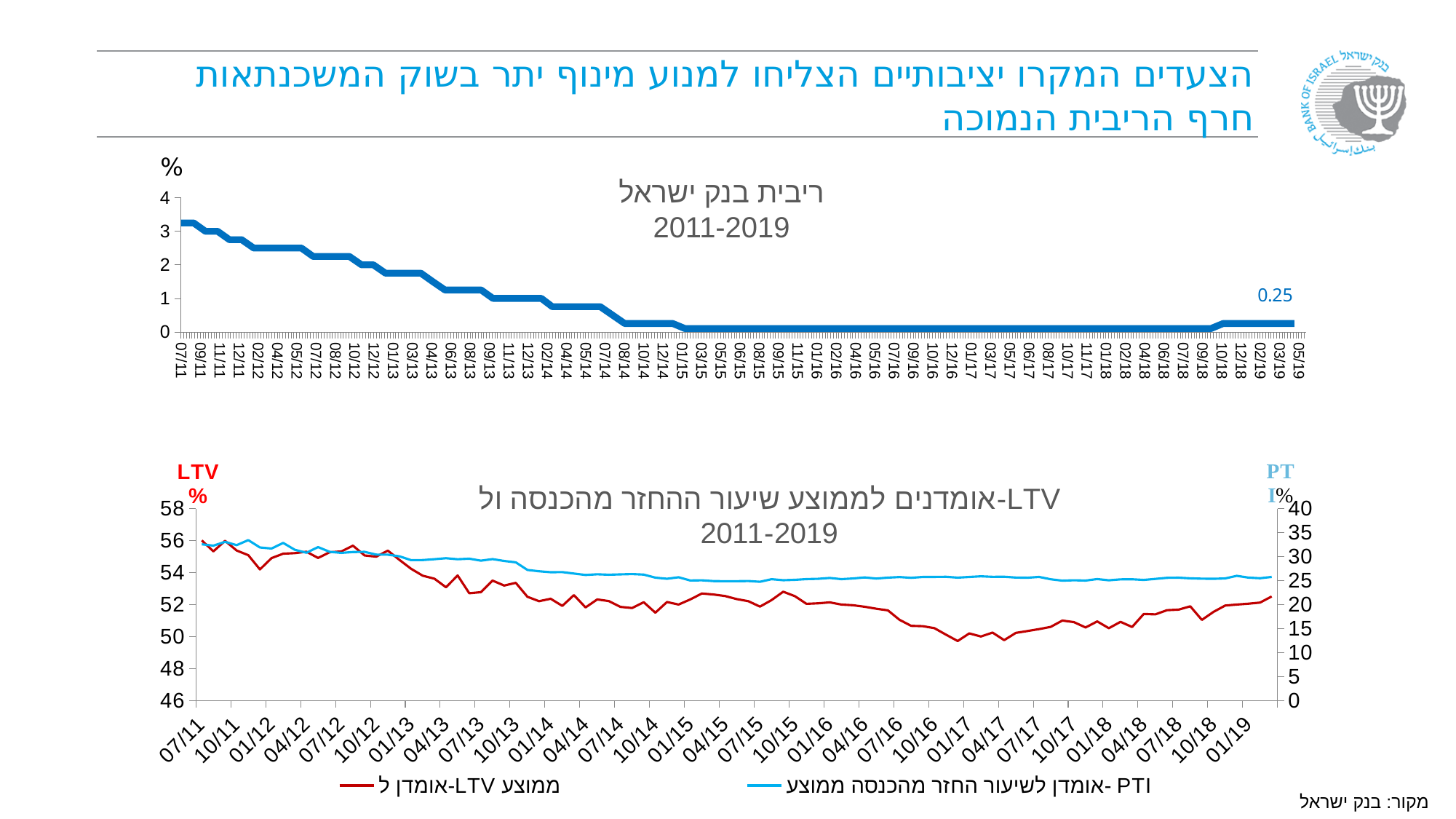
In the bottom chart, is the LTV value at 07/11 greater or less than 54? greater In the bottom chart, does the PTI series generally rise or fall from 07/11 to 01/19? fall In the top chart (ריבית בנק ישראל), is the value at 07/11 larger or smaller than the value at 05/19? larger In the bottom chart, is the PTI value at 01/19 greater or less than 30? less In the top chart (ריבית בנק ישראל), is the value at 01/16 greater or less than 1? less What kind of chart is the bottom chart (LTV and PTI estimates 2011-2019)? line chart In the top chart (ריבית בנק ישראל), what value is printed as the data label at the end of the line (05/19)? 0.25 In the top chart (ריבית בנק ישראל), does the interest rate generally rise or fall from 07/11 to 05/19? fall What kind of chart is the top chart titled 'ריבית בנק ישראל 2011-2019'? line chart In the bottom chart, which series is drawn in red? ממוצע LTV-אומדן ל How many series does the legend of the bottom chart (LTV and PTI estimates) list? 2